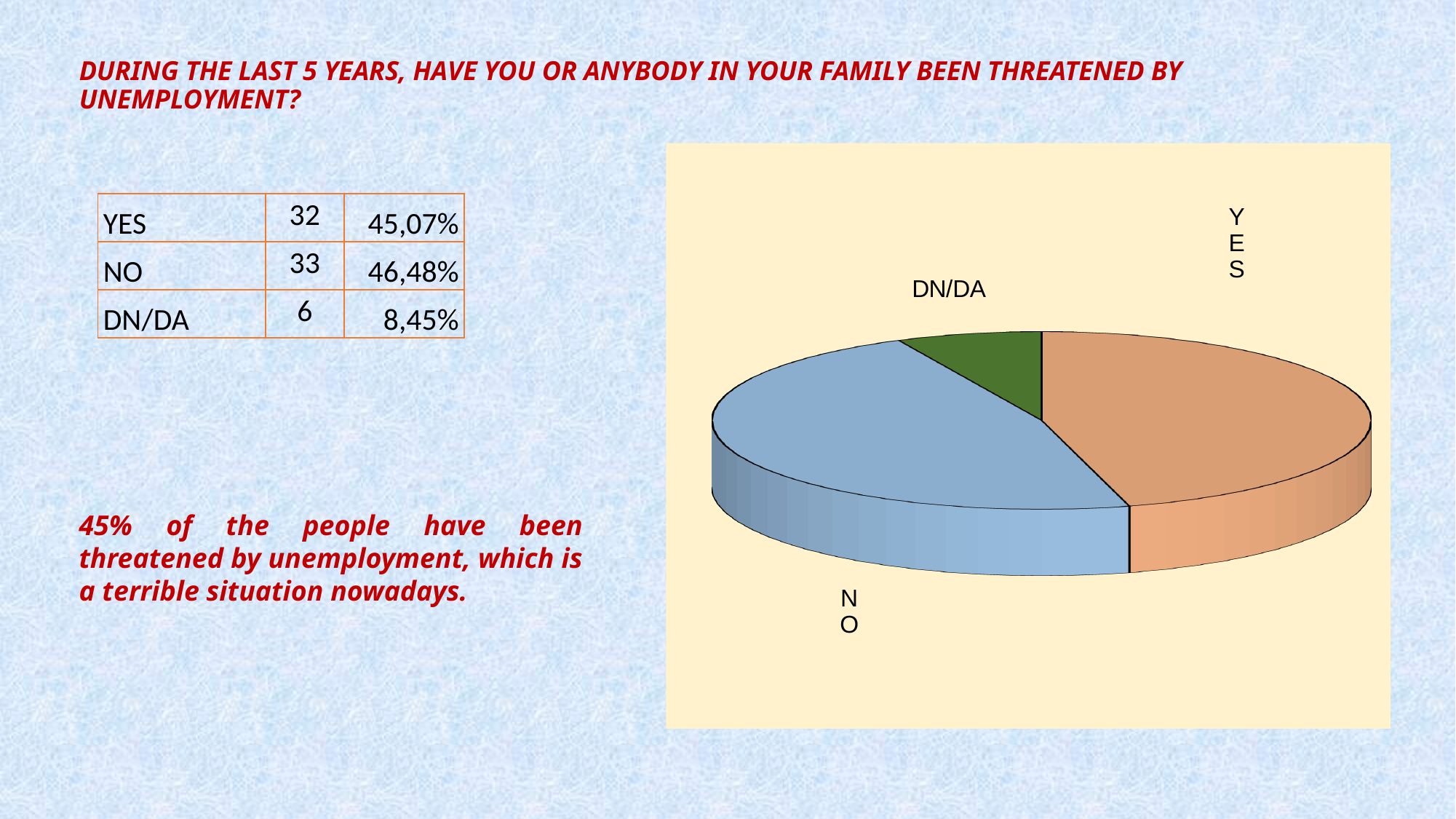
According to the table on the slide, what percentage of respondents answered YES? 45,07% What colour is the DN/DA slice in the pie chart? green How many respondents answered YES according to the table? 32 How many slices does the pie chart have? 3 According to the table on the slide, what percentage of respondents answered DN/DA? 8,45% Which category has the smallest slice in the pie chart? DN/DA Which slice is larger in the pie chart, YES or DN/DA? YES What is the difference in the number of respondents between NO and YES according to the table? 1 What kind of chart is shown on the slide? pie chart What colour is the NO slice in the pie chart? light blue According to the table on the slide, what percentage of respondents answered NO? 46,48% How many respondents answered DN/DA according to the table? 6